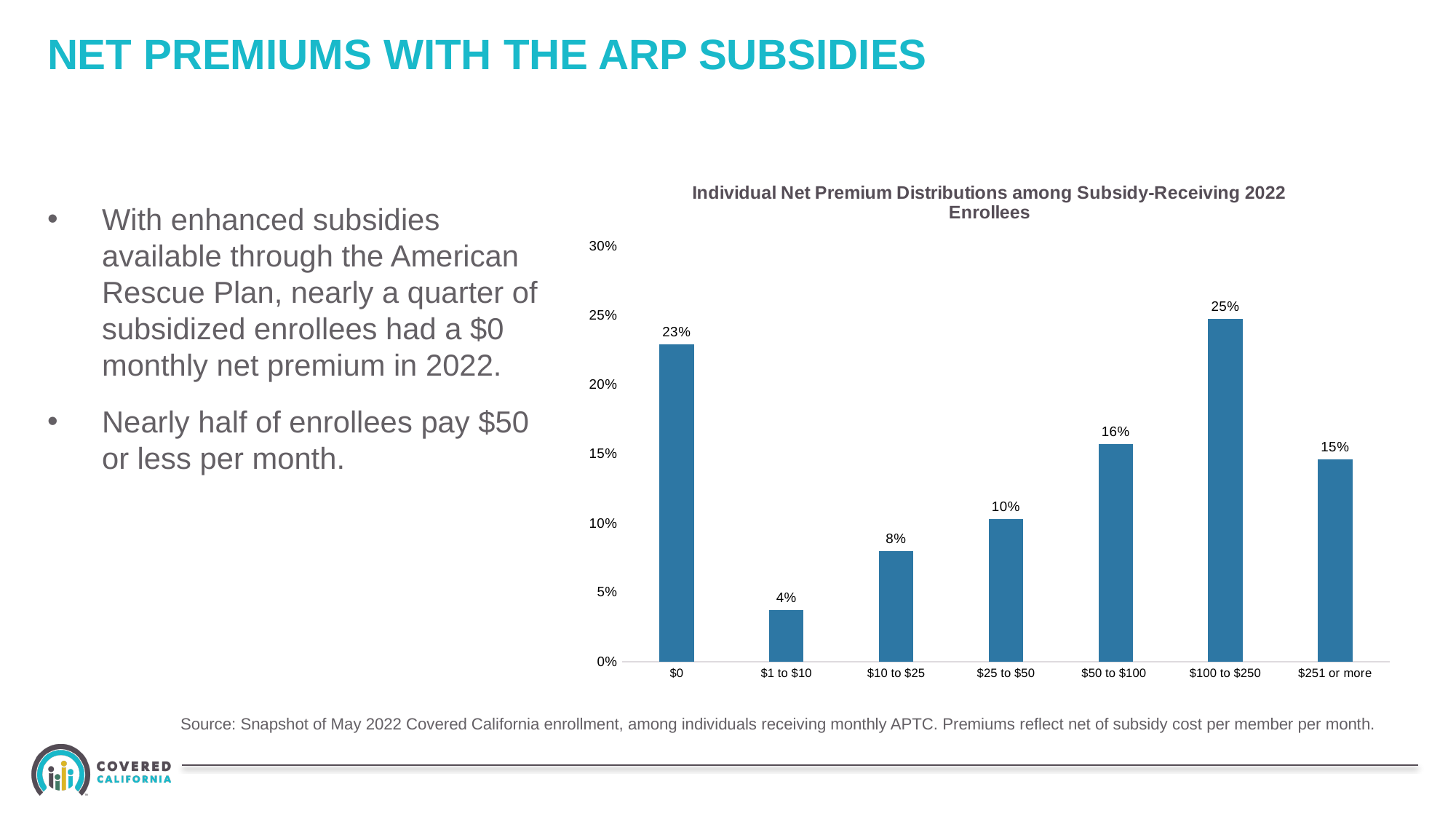
Is the value for $1 to $10 greater or less than 5%? less Which net premium category has the highest share of enrollees? $100 to $250 What is the difference between the $100 to $250 value and the $0 value? 2% Which is larger, the value for $0 or the value for $251 or more? $0 What kind of chart is shown on the slide? Bar chart What is the value for the $251 or more category? 15% Which net premium category has the lowest share of enrollees? $1 to $10 What is the value for the $50 to $100 category? 16% What is the title of the chart? Individual Net Premium Distributions among Subsidy-Receiving 2022 Enrollees What percentage of subsidy-receiving enrollees had a $0 net premium? 23% How many net premium categories are shown on the x axis? 7 What is the difference between the $25 to $50 value and the $10 to $25 value? 2%